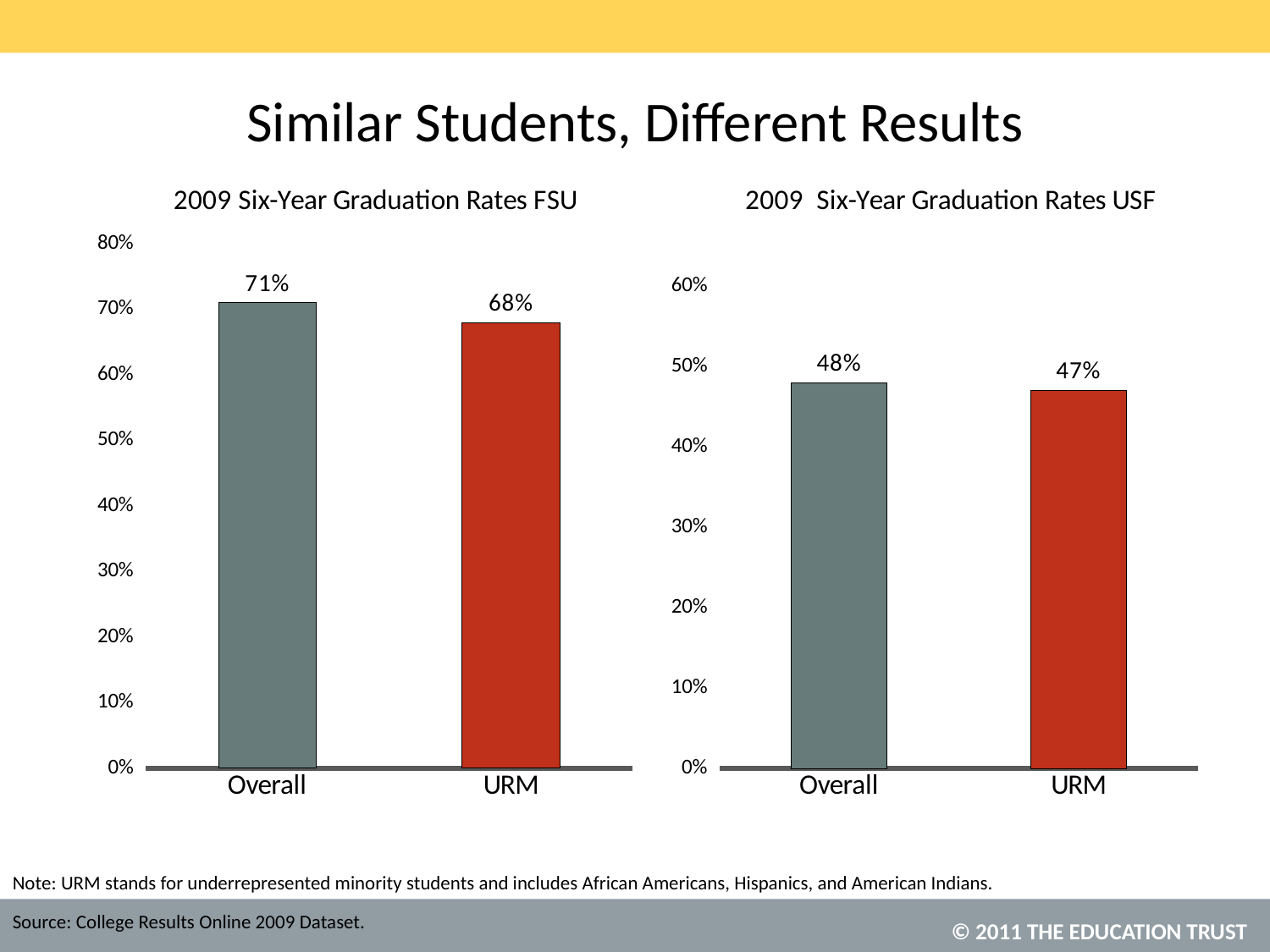
In the chart titled '2009 Six-Year Graduation Rates FSU', what is the value for Overall? 71% In the chart titled '2009 Six-Year Graduation Rates USF', is the value for Overall greater or less than 40%? greater In the chart titled '2009 Six-Year Graduation Rates USF', which category has the lower value? URM In the chart titled '2009 Six-Year Graduation Rates FSU', what is the value for URM? 68% In the chart titled '2009 Six-Year Graduation Rates USF', what is the value for URM? 47% In the chart titled '2009 Six-Year Graduation Rates FSU', how many categories are shown on the x axis? 2 In the chart titled '2009 Six-Year Graduation Rates FSU', what is the difference between the Overall and URM values? 3% In the chart titled '2009 Six-Year Graduation Rates FSU', which category has the higher value? Overall In the chart titled '2009 Six-Year Graduation Rates USF', what is the difference between the Overall and URM values? 1% What is the title of the chart on the left side of the slide? 2009 Six-Year Graduation Rates FSU What kind of chart is the chart titled '2009 Six-Year Graduation Rates USF'? Bar chart In the chart titled '2009 Six-Year Graduation Rates USF', what is the value for Overall? 48%